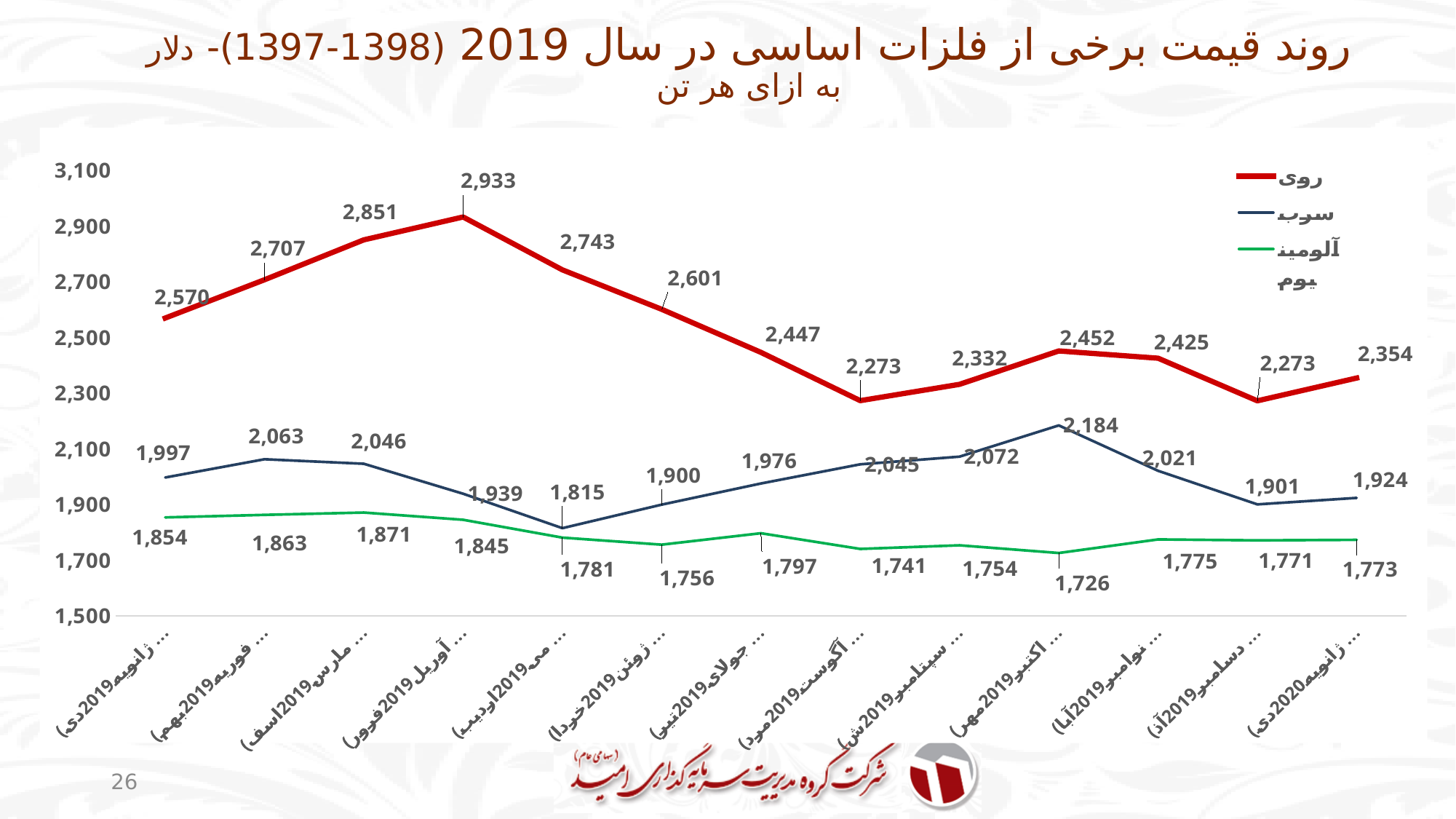
What is the value of the آلومینیوم series for ژانویه 2020 (دی)? 1,773 Which is larger: the سرب value in فوریه 2019 (بهمن) or in مارس 2019 (اسفند)? فوریه 2019 (بهمن) Does the روی series rise or fall from آوریل 2019 (فروردین) to آگوست 2019 (مرداد)? fall What type of chart is shown on the slide? line chart What is the difference between the روی value in ژانویه 2019 (دی) and in ژانویه 2020 (دی)? 216 What is the value of the روی series for آوریل 2019 (فروردین)? 2,933 How many series does the legend list? 3 In which month does the آلومینیوم series reach its lowest value? اکتبر 2019 (مهر) What is the value of the سرب series for اکتبر 2019 (مهر)? 2,184 Which colour is used for the روی series line? red In which month does the روی series reach its highest value? آوریل 2019 (فروردین) How many months (data points) are plotted along the x axis? 13